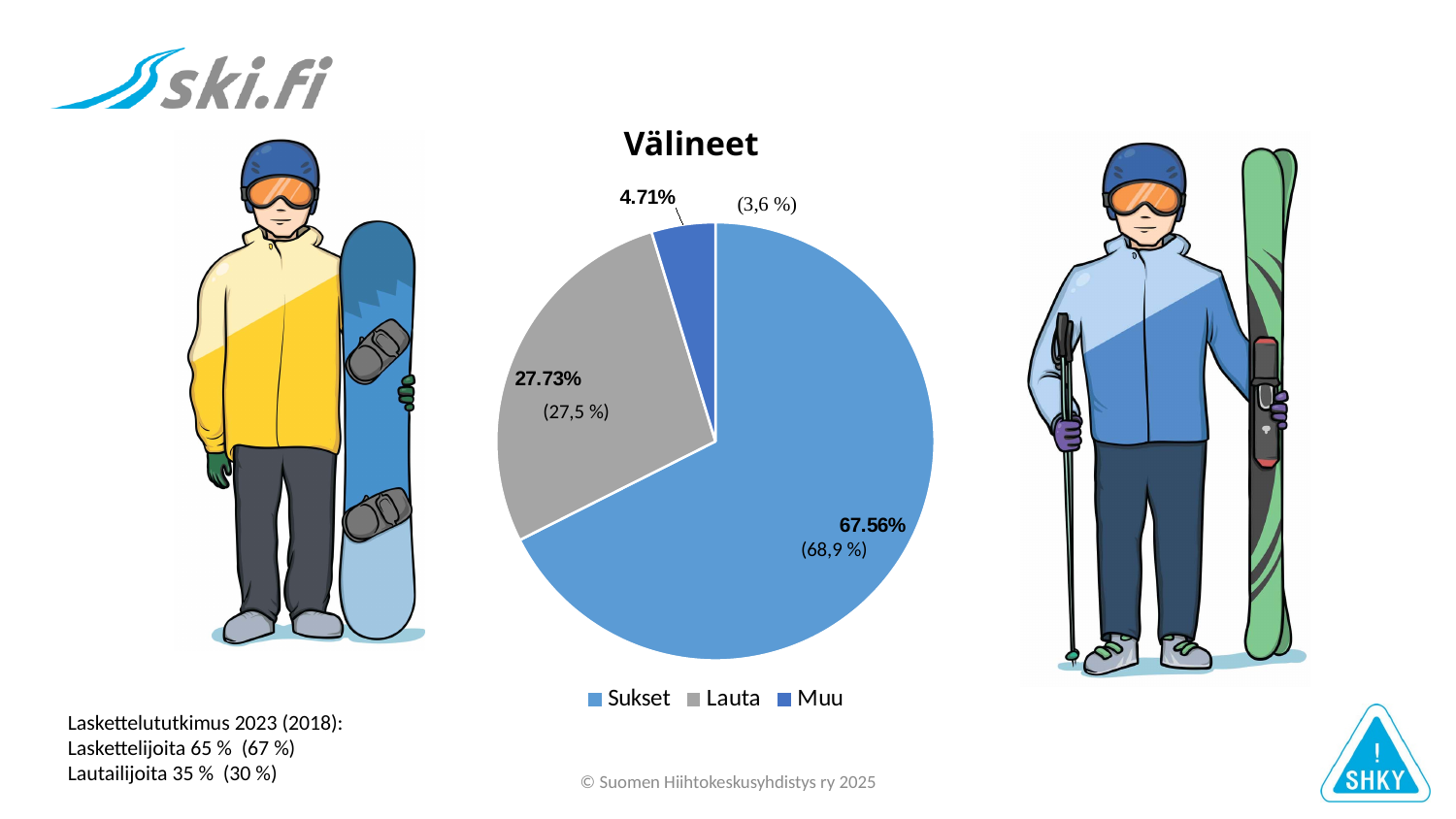
What percentage of the pie chart is labelled for Muu? 4.71% How many slices does the pie chart have? 3 What kind of chart is shown on the slide? pie chart What percentage of the pie chart is labelled for Lauta? 27.73% Which category has the largest slice in the pie chart? Sukset What value in parentheses is shown next to the Sukset slice's 67.56% label? (68,9 %) What percentage of the pie chart is labelled for Sukset? 67.56% Which slice is larger in the pie chart, Lauta or Muu? Lauta Which category has the smallest slice in the pie chart? Muu How many entries does the legend of the pie chart list? 3 What is the difference in percentage points between the Sukset slice (67.56%) and the Lauta slice (27.73%)? 39.83 What is the title of the pie chart? Välineet